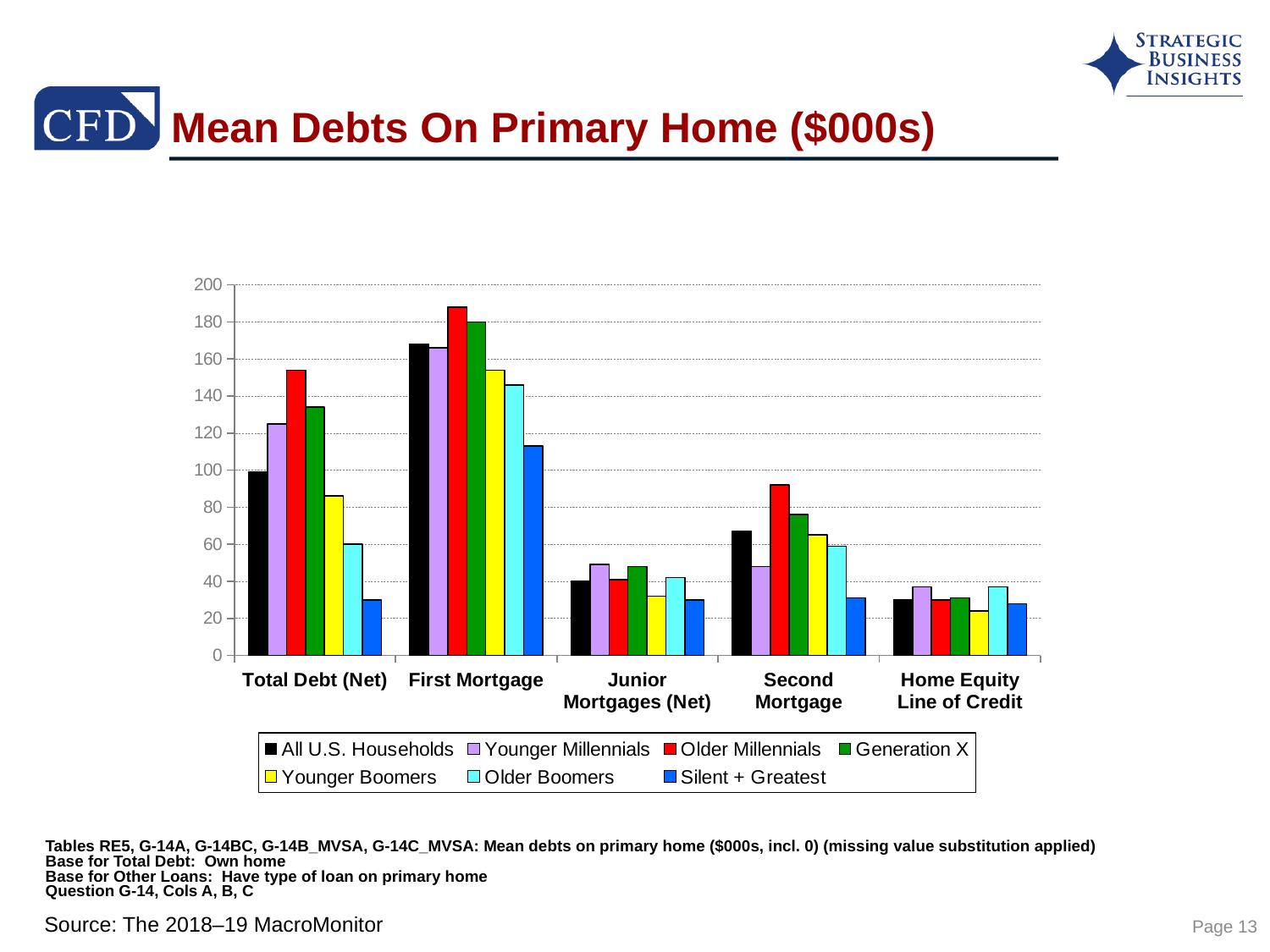
What kind of chart is shown on the slide? bar chart Is the Second Mortgage value for Older Millennials greater or less than 80? greater How many debt categories are shown along the x axis? 5 Which series has the highest bar in the First Mortgage group? Older Millennials Is the Total Debt (Net) value for Older Millennials greater or less than 140? greater Is the Total Debt (Net) value for Older Boomers greater or less than 80? less For Older Millennials, which debt category has the highest bar? First Mortgage How many series does the legend list? 7 What is the title of the chart? Mean Debts On Primary Home ($000s) In the Second Mortgage group, which is larger: Older Millennials or Generation X? Older Millennials Which series has the lowest bar in the Total Debt (Net) group? Silent + Greatest